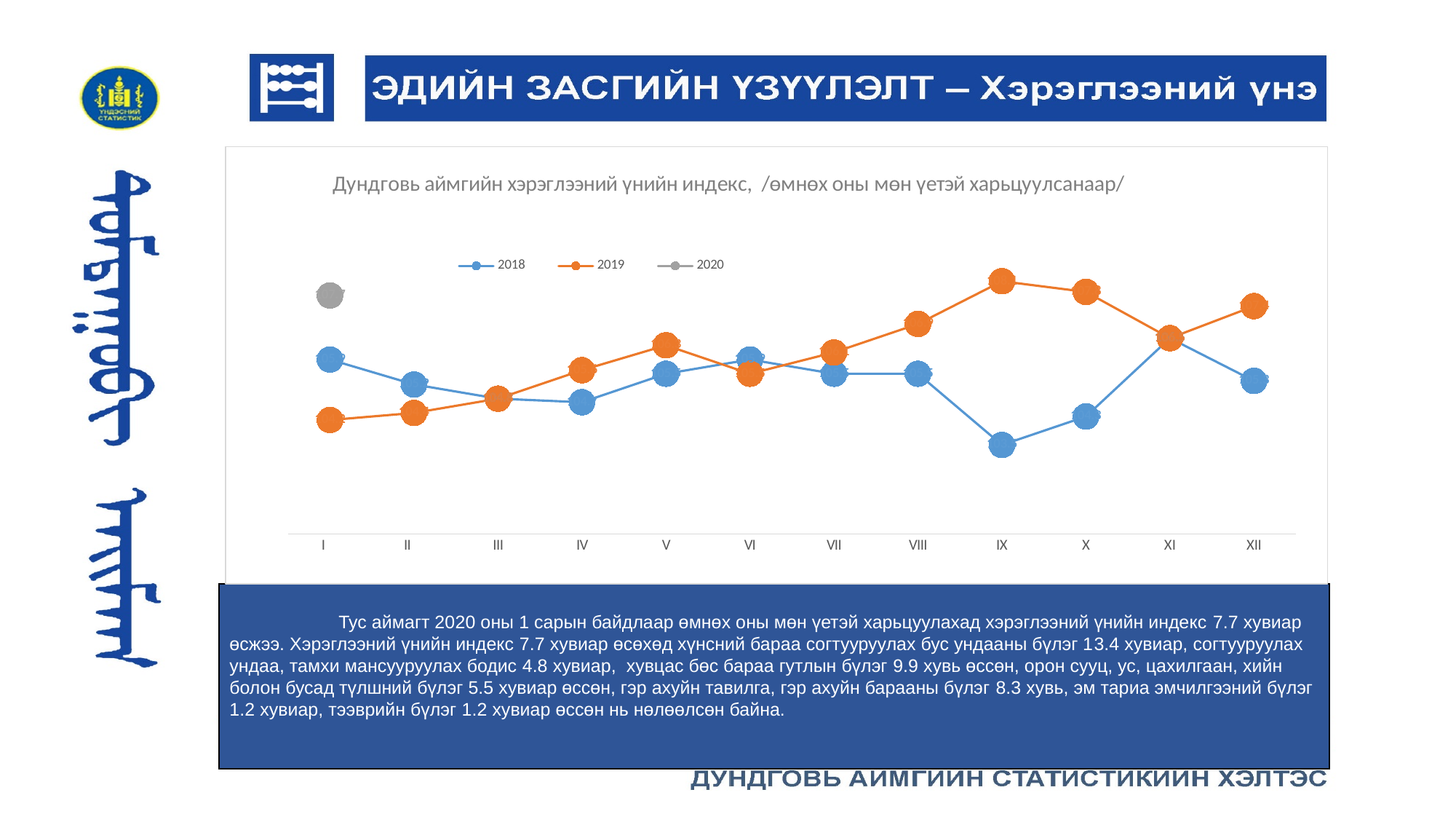
In month I, which series has the higher value, 2018 or 2019? 2018 What colour is the 2019 series drawn in? orange In month I, which of the three series has the highest value? 2020 Which series are listed in the legend? 2018, 2019, 2020 What kind of chart is shown on the slide? line chart In which month does the 2019 series have its lowest value? I Does the 2019 series generally rise or fall from month I to month IX? rise In which month does the 2019 series reach its highest value? IX In month IX, which series has the higher value, 2018 or 2019? 2019 How many categories are shown on the x axis? 12 How many series does the legend list? 3 In which month does the 2018 series have its lowest value? IX